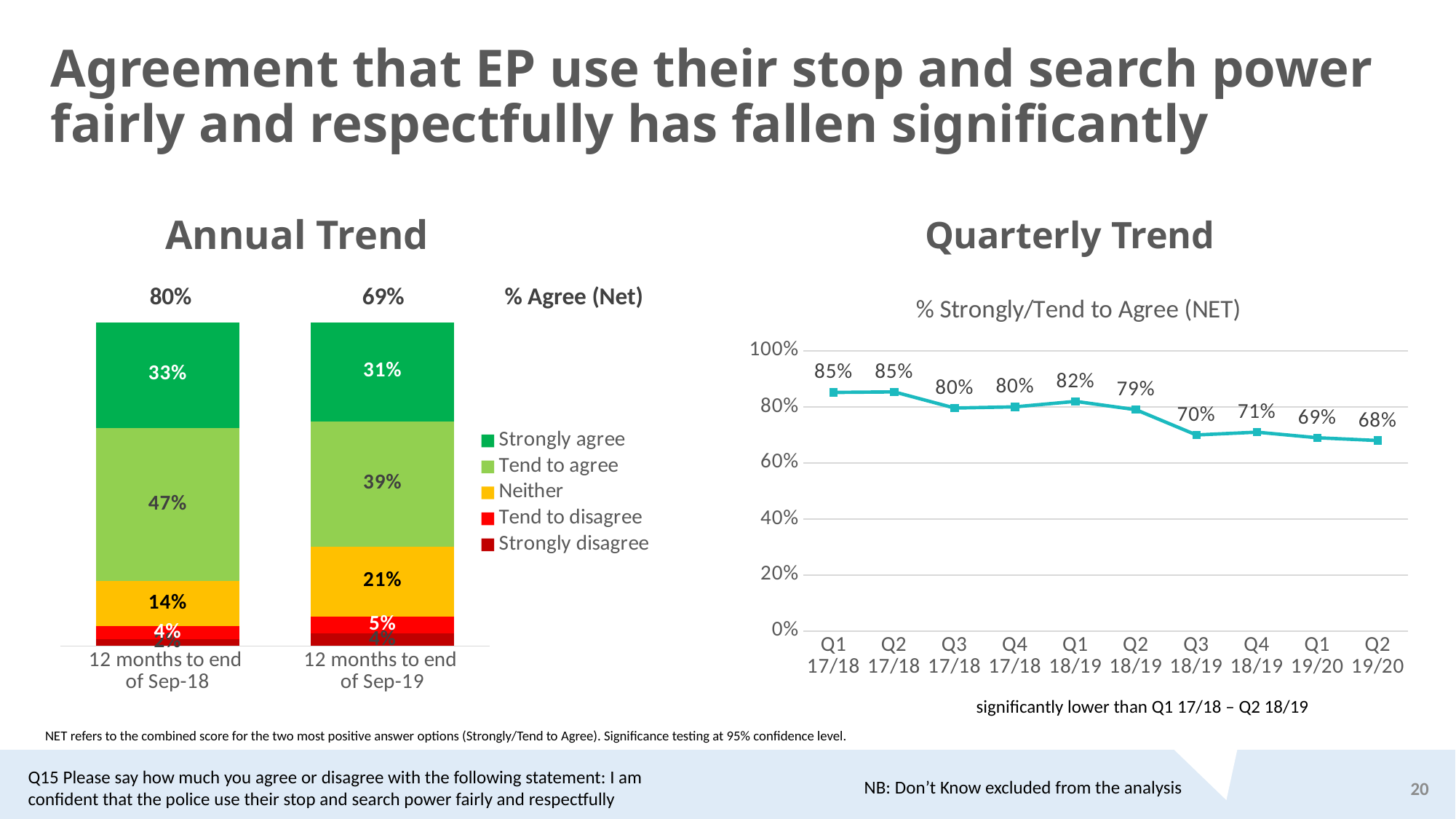
In the Quarterly Trend chart, what is the difference between Q2 18/19 and Q3 18/19? 9 percentage points In the Annual Trend chart, by how many percentage points did the % Agree (Net) fall from Sep-18 to Sep-19? 11 percentage points In the Annual Trend chart, what percentage said 'Neither' in the 12 months to end of Sep-19? 21% What type of chart is the Annual Trend chart? Stacked bar chart How many series does the legend of the Annual Trend chart list? 5 In the Annual Trend chart, what is the % Agree (Net) for 12 months to end of Sep-19? 69% How many quarters are plotted in the Quarterly Trend chart? 10 In the Annual Trend chart, what percentage said 'Tend to agree' in the 12 months to end of Sep-18? 47% In the Quarterly Trend chart, do the values generally rise or fall from Q1 17/18 to Q2 19/20? Fall In the Annual Trend chart, which period has the larger 'Strongly agree' share, 12 months to end of Sep-18 or Sep-19? 12 months to end of Sep-18 In the Quarterly Trend chart, what is the value for Q2 19/20? 68% In the Quarterly Trend chart, which quarter has the lowest value? Q2 19/20